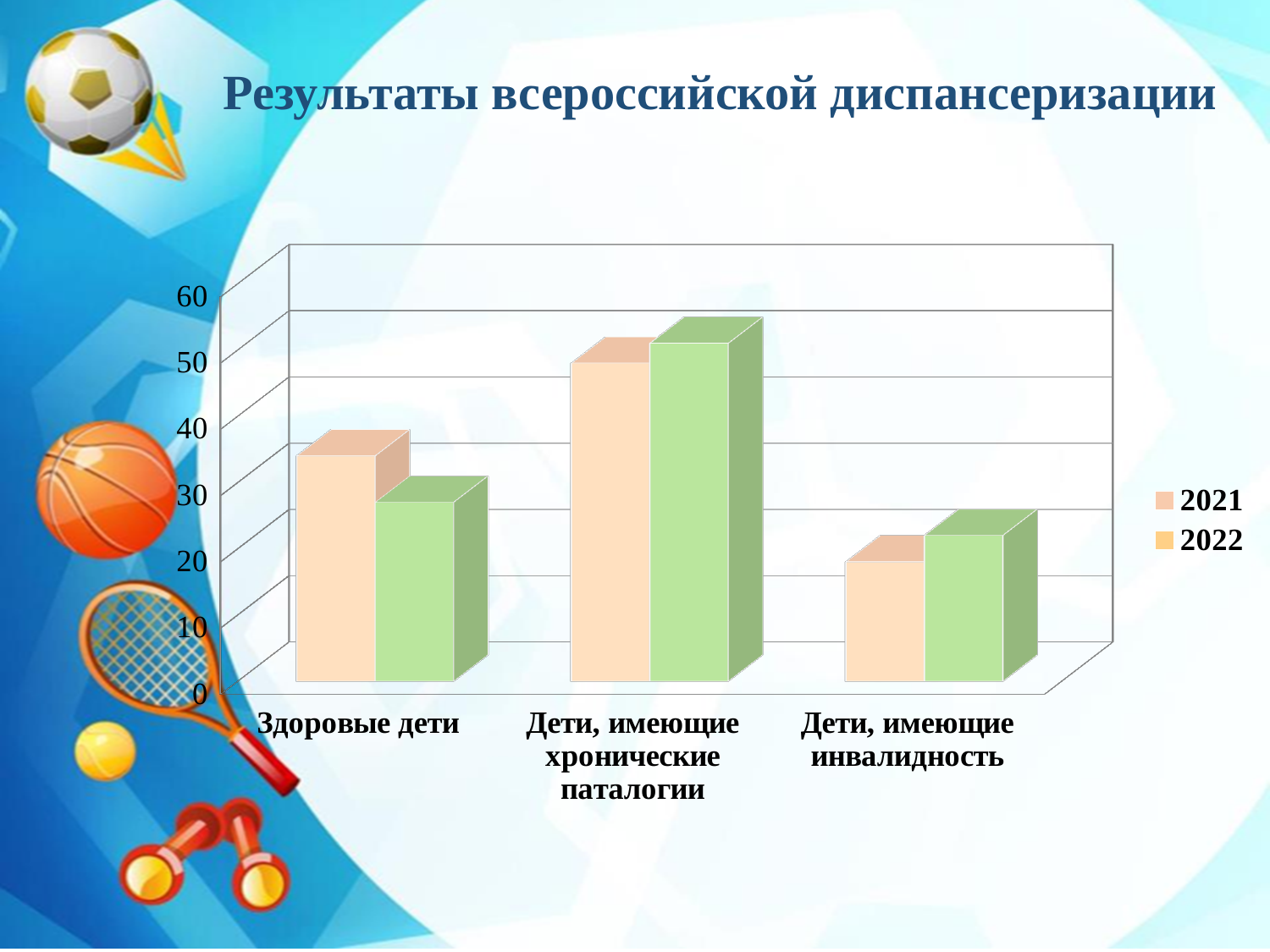
How many series does the chart legend list? 2 Is the 2022 value for Дети, имеющие хронические паталогии greater or less than 40? greater For Дети, имеющие инвалидность, which series has the larger value, 2021 or 2022? 2022 How many categories are shown on the x axis of the chart? 3 Is the 2021 value for Дети, имеющие инвалидность greater or less than 30? less For Здоровые дети, which series has the larger value, 2021 or 2022? 2021 Is the 2021 value for Здоровые дети greater or less than 30? greater Which category has the highest value for the 2021 series? Дети, имеющие хронические паталогии Which category has the lowest value for the 2022 series? Дети, имеющие инвалидность What are the series names listed in the chart legend? 2021, 2022 What kind of chart is shown on the slide? bar chart What is the title of the slide containing the chart? Результаты всероссийской диспансеризации